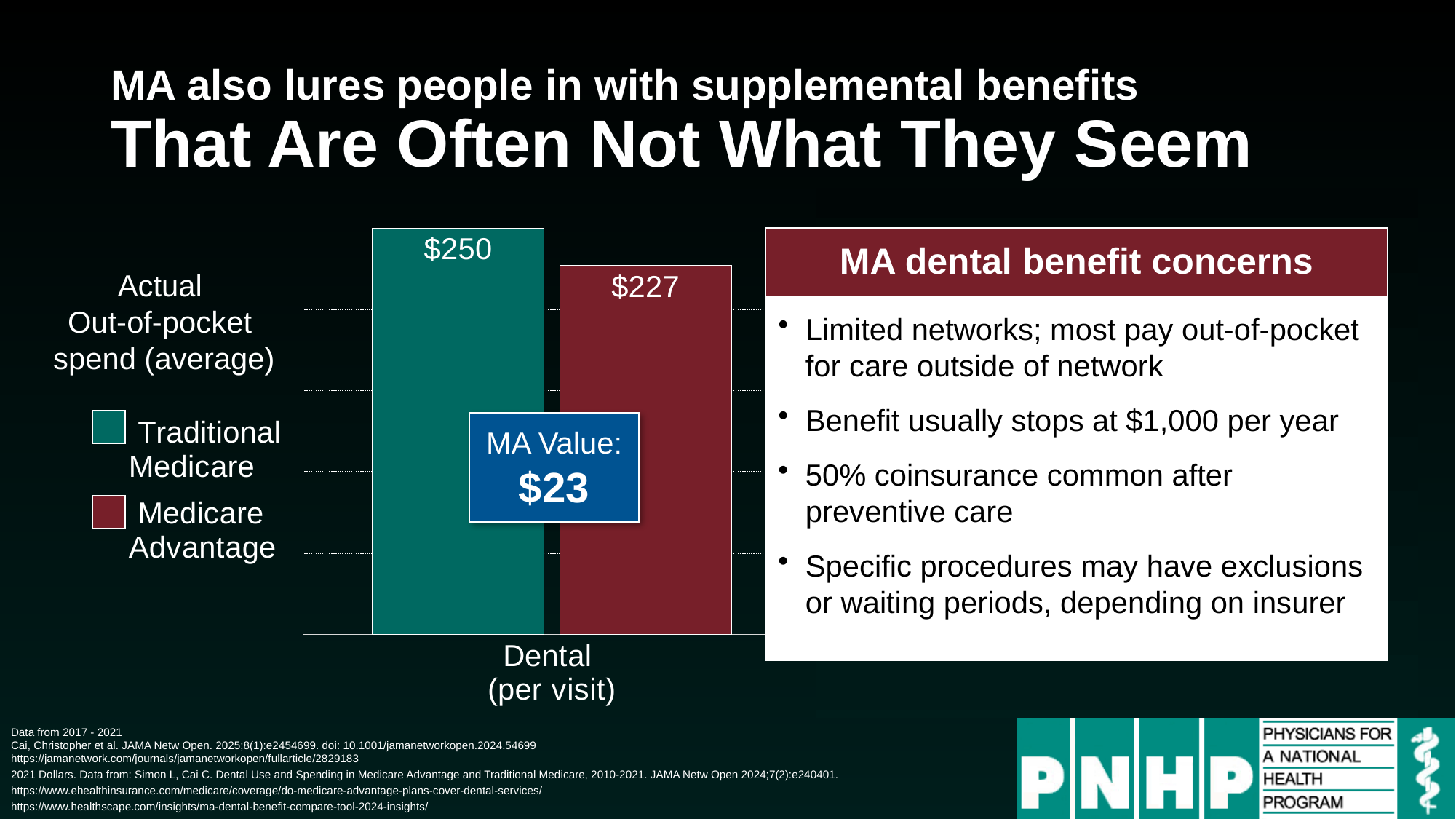
What category is shown on the x axis of the chart? Dental (per visit) How many series does the chart legend list? 2 What is the difference between the Traditional Medicare and Medicare Advantage out-of-pocket dental spend per visit? $23 What is the actual out-of-pocket spend per dental visit for Medicare Advantage? $227 Which series has the lowest out-of-pocket dental spend per visit? Medicare Advantage What is the MA Value shown in the callout box on the chart? $23 How many categories are plotted on the chart's x axis? 1 Which series has the higher out-of-pocket dental spend per visit, Traditional Medicare or Medicare Advantage? Traditional Medicare What colour represents Medicare Advantage in the chart legend? Dark red What is the actual out-of-pocket spend per dental visit for Traditional Medicare? $250 What kind of chart is shown on the slide? Bar chart